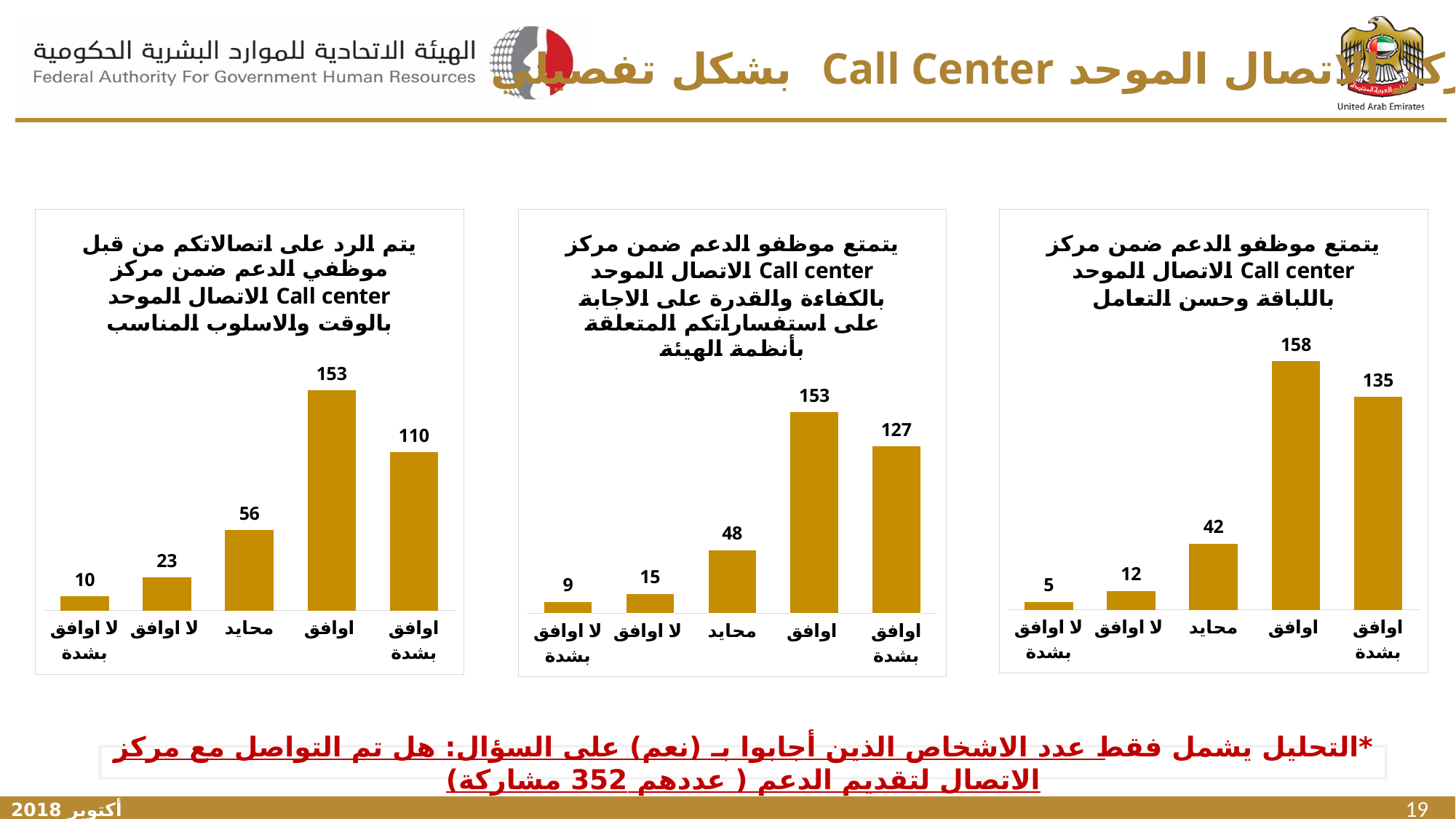
In the left chart (يتم الرد على اتصالاتكم ... بالوقت والاسلوب المناسب), what is the value for اوافق? 153 In the left chart, what is the difference between the values for اوافق and اوافق بشدة? 43 In the left chart, what is the total of the values for لا اوافق بشدة, لا اوافق and محايد? 89 In the middle chart, which category has the lowest value? لا اوافق بشدة In the right chart, which category has the highest value? اوافق In the right chart, what is the difference between the values for اوافق and محايد? 116 In the middle chart (بالكفاءة والقدرة على الاجابة), what is the value for اوافق بشدة? 127 In the left chart, what is the value for محايد? 56 How many categories are shown on the x axis of the middle chart? 5 What type of chart is used in the three charts on this slide? bar chart In the right chart (باللباقة وحسن التعامل), what is the value for لا اوافق بشدة? 5 Which is larger: the value for اوافق بشدة in the middle chart or in the right chart? right chart (135)